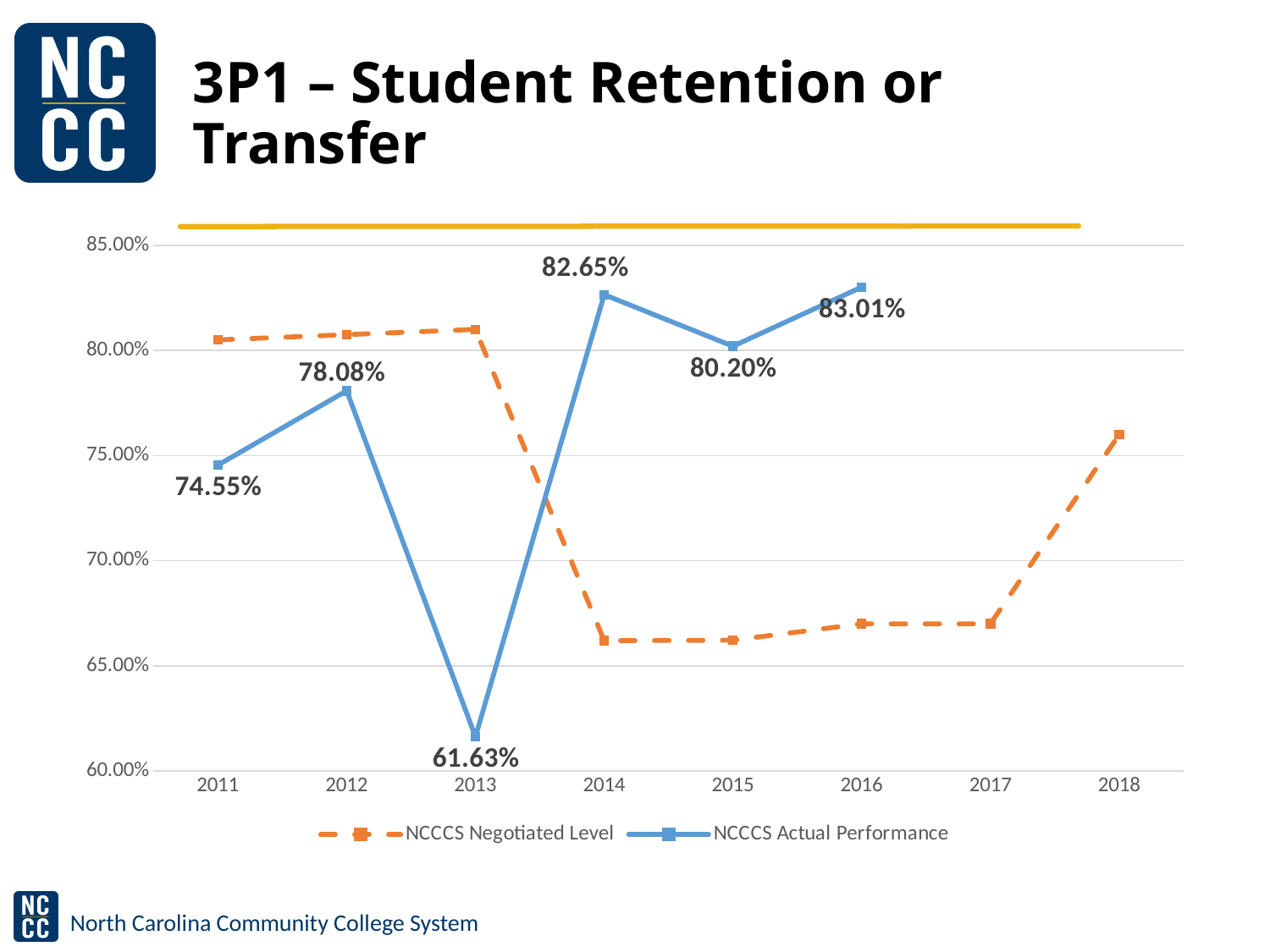
What is the difference between the NCCCS Actual Performance values for 2014 and 2013? 21.02 percentage points In which year is NCCCS Actual Performance lowest? 2013 Is the NCCCS Negotiated Level for 2014 greater or less than 70.00%? less What kind of chart is shown on the slide? Line chart How many years are shown on the x axis of the chart? 8 Is the NCCCS Negotiated Level for 2018 greater or less than 75.00%? greater Which year has the higher NCCCS Actual Performance, 2014 or 2015? 2014 In which year is NCCCS Actual Performance highest? 2016 How many series does the chart's legend list? 2 What is the NCCCS Actual Performance value for 2016? 83.01% What is the NCCCS Actual Performance value for 2013? 61.63% What is the NCCCS Actual Performance value for 2011? 74.55%